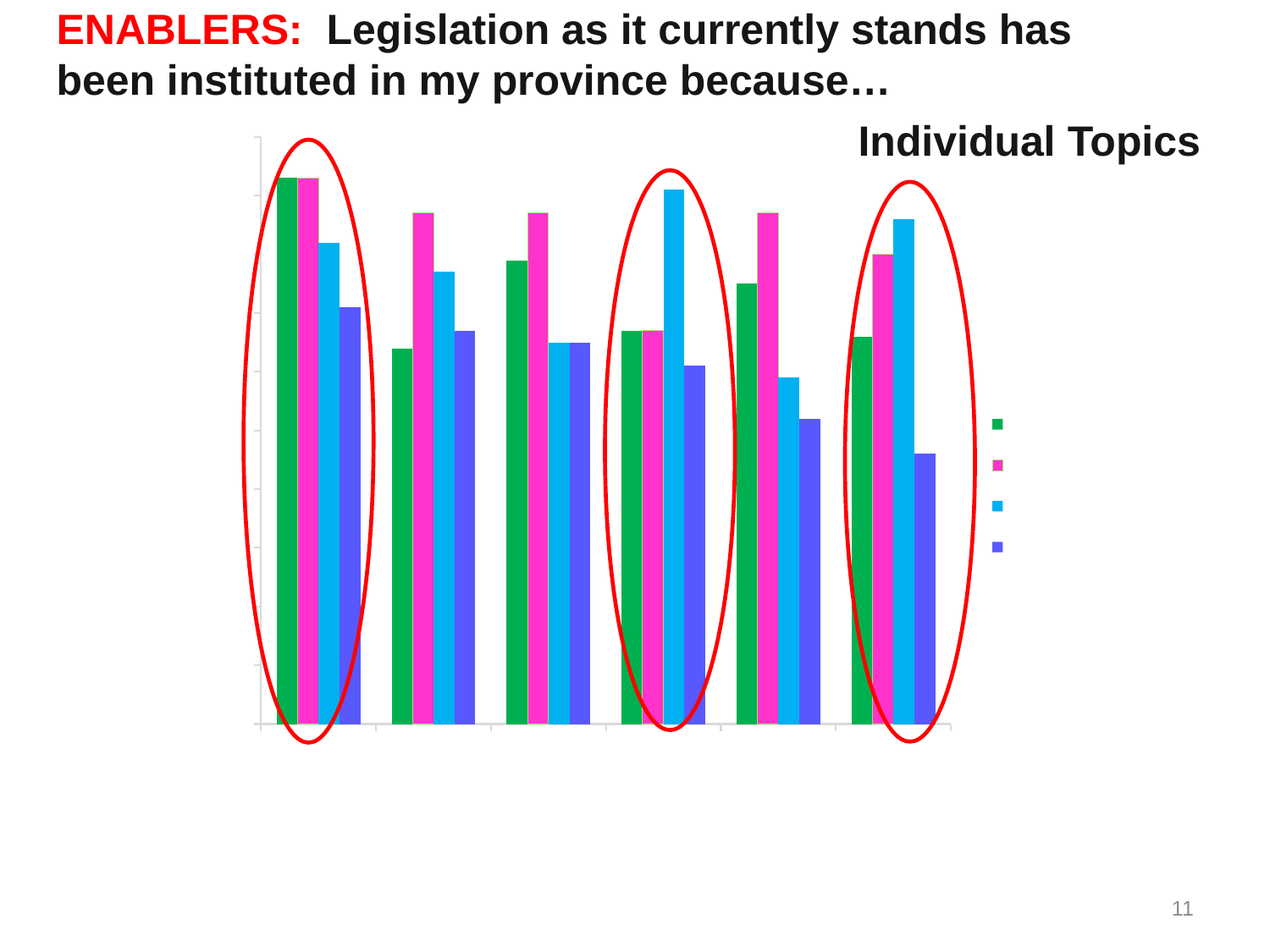
In the sixth group of bars from the left, which coloured bar is the tallest? light blue In the first group of bars from the left, is the light blue bar taller or shorter than the purple bar? taller What text label appears at the top right of the chart? Individual Topics In the fifth group of bars from the left, which coloured bar is the shortest? purple What kind of chart is shown on the slide? bar chart In the fourth group of bars from the left, which coloured bar is the tallest? light blue In the sixth group of bars from the left, which coloured bar is the shortest? purple In the second group of bars from the left, which coloured bar is the tallest? pink How many groups of bars (categories) are plotted along the x axis? 6 How many series does the legend list? 4 How many groups of bars are circled in red on the chart? 3 In the fourth group of bars from the left, is the green bar taller or shorter than the light blue bar? shorter